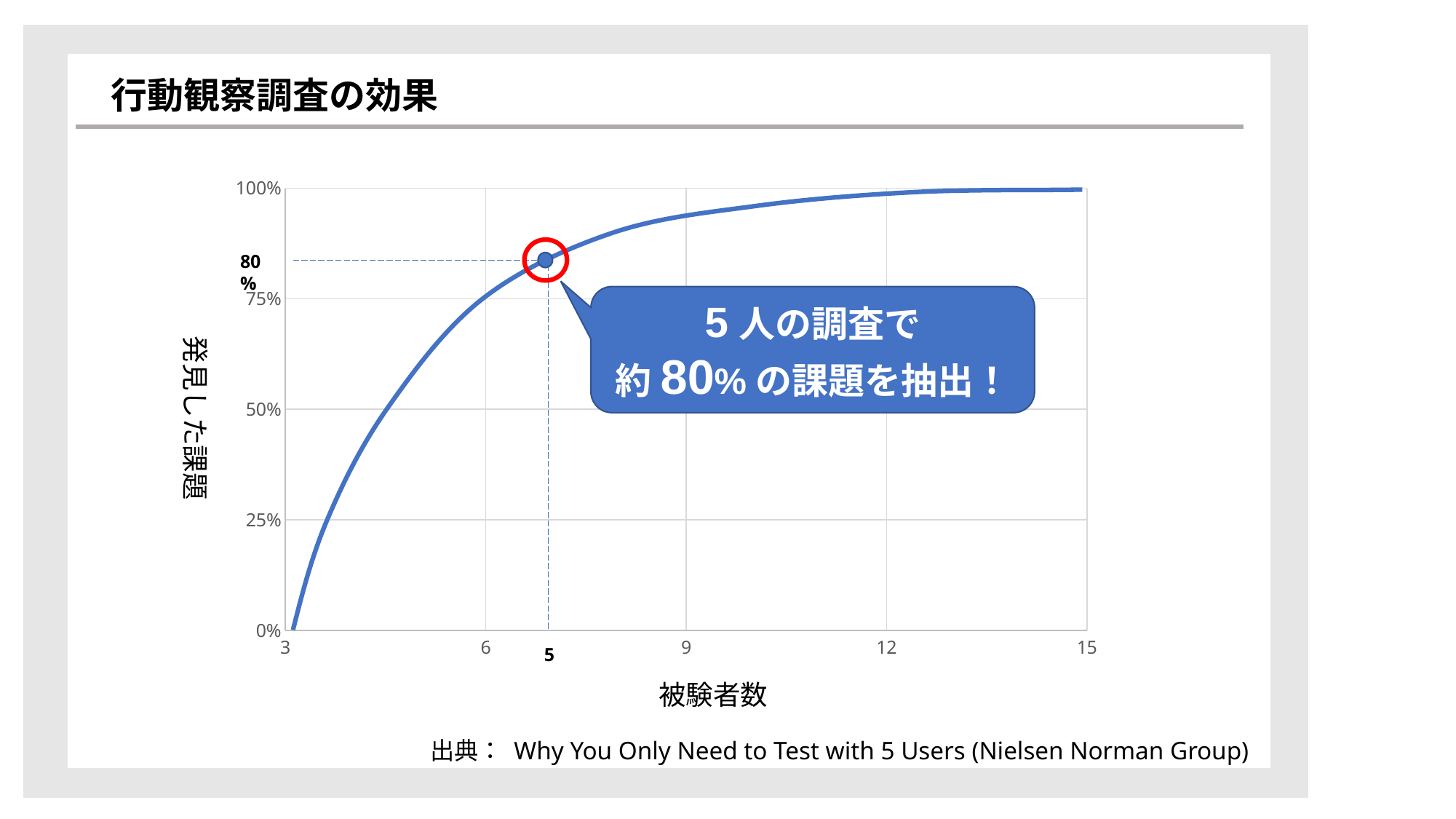
What is the highest value shown on the y axis of the chart? 100% Is the value of the curve at 12 被験者数 greater or less than 50%? greater According to the callout, how many people are needed in the survey to extract about 80% of the issues? 5人 What kind of chart is shown on the slide? line chart Is the value of the curve at 6 被験者数 greater or less than 75%? greater Is the value of the curve at 9 被験者数 greater or less than 75%? greater What is the title of the slide containing the chart? 行動観察調査の効果 Does the curve rise or fall as 被験者数 increases along the x axis? rise What is the label of the x axis of the chart? 被験者数 What is the largest 被験者数 value shown on the x axis of the chart? 15 What value does the highlighted point at 5 被験者数 show on the y axis? 80%